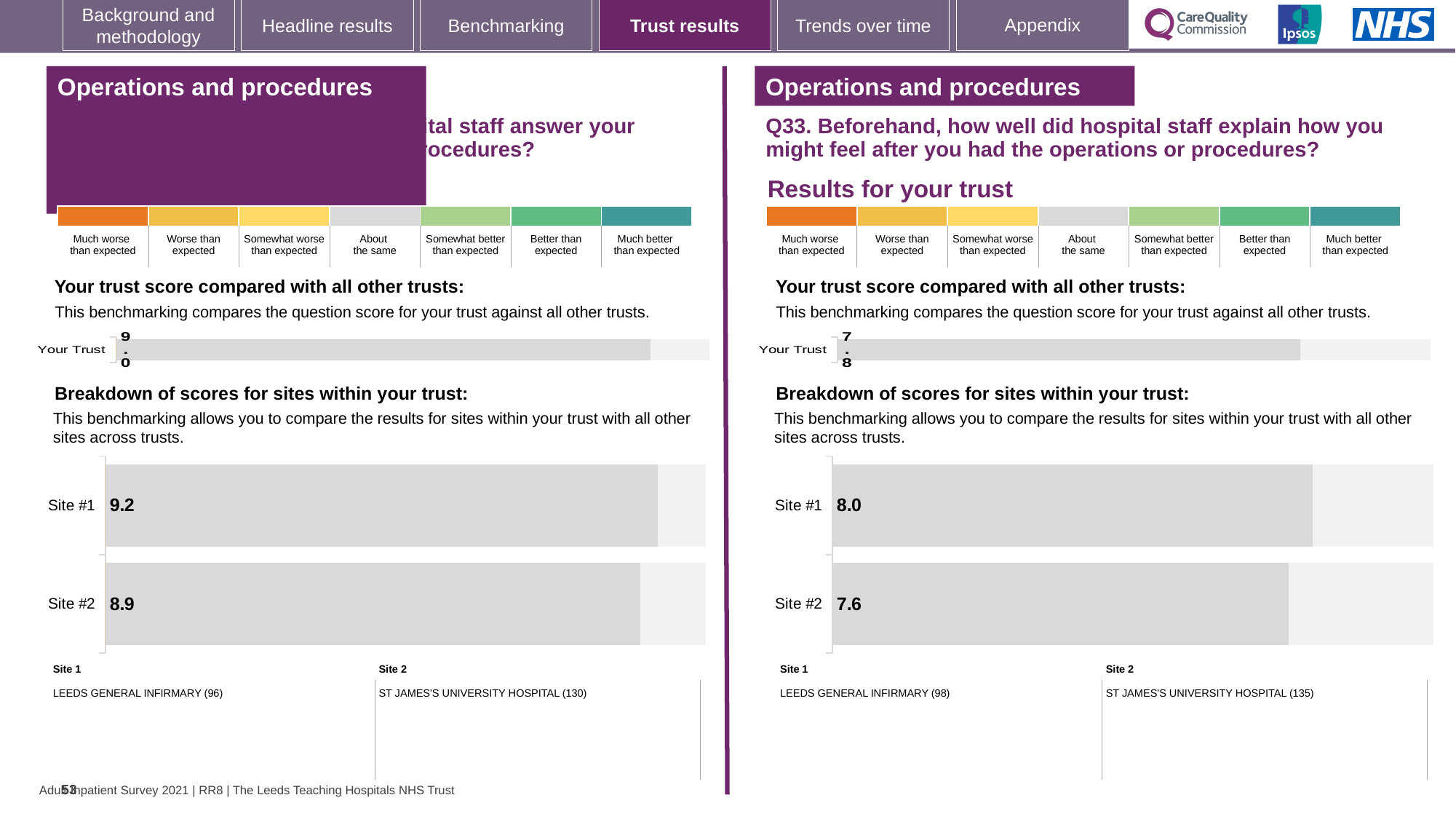
In the right panel (Q33) site breakdown chart, which site has the higher score? Site #1 In the left panel site breakdown chart, what is the difference between the Site #1 and Site #2 scores? 0.3 In the right panel (Q33), what is the score for Site #2 in the breakdown of scores for sites within your trust? 7.6 How many sites are shown in the right panel (Q33) breakdown of scores chart? 2 In the left panel, what is the score for Site #1 in the breakdown of scores for sites within your trust? 9.2 In the left panel, what is the 'Your Trust' score shown in the trust score comparison chart? 9.0 In the right panel (Q33) site breakdown chart, what is the difference between the Site #1 and Site #2 scores? 0.4 In the right panel (Q33), what is the score for Site #1 in the breakdown of scores for sites within your trust? 8.0 In the right panel (Q33), what is the 'Your Trust' score shown in the trust score comparison chart? 7.8 In the left panel, what is the score for Site #2 in the breakdown of scores for sites within your trust? 8.9 What kind of chart is used for the breakdown of scores for sites within your trust in the right panel (Q33)? Bar chart In the left panel site breakdown chart, which site has the lower score? Site #2